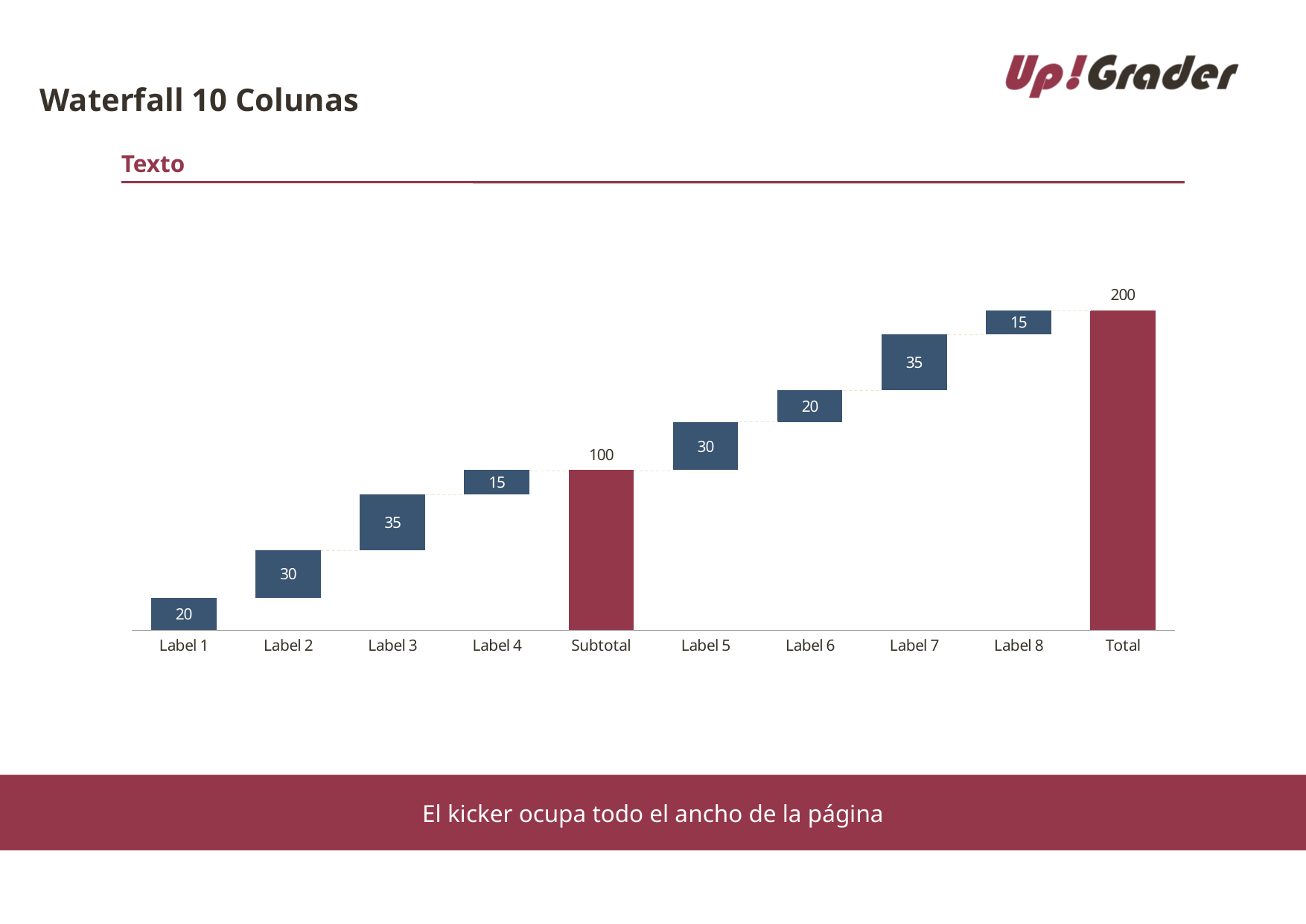
What is the value shown for the Total bar? 200 What is the title of the slide containing the chart? Waterfall 10 Colunas What is the value shown for Label 3? 35 What is the value shown for the Subtotal bar? 100 What is the value shown for Label 1? 20 How many categories are shown on the x axis? 10 What is the difference between the values for Label 3 and Label 4? 20 Which is larger, the value for Label 2 or the value for Label 4? Label 2 What is the difference between the Total and the Subtotal values? 100 What is the value shown for Label 6? 20 What colour are the Subtotal and Total bars? Dark red What kind of chart is shown on the slide? Waterfall bar chart